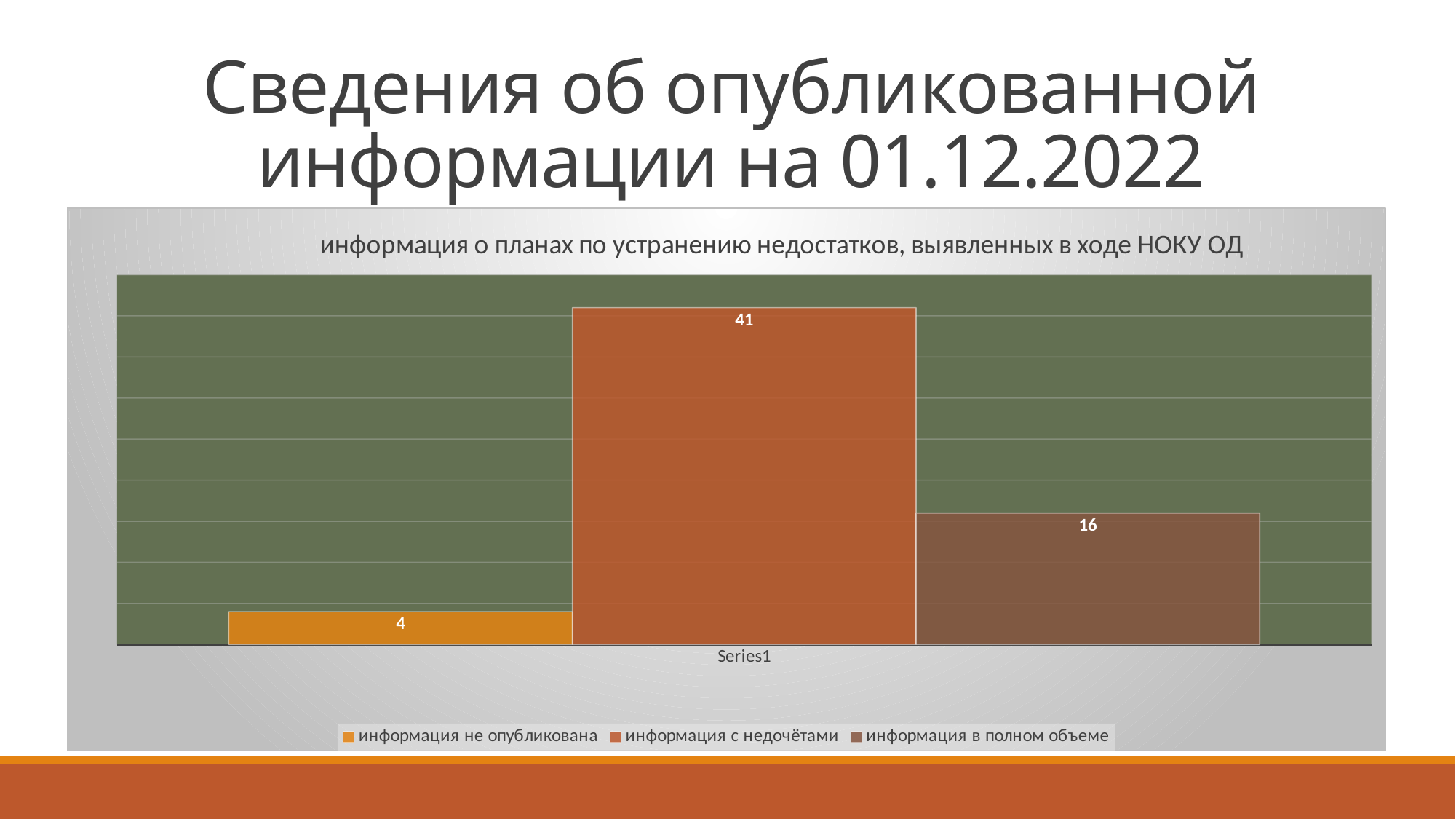
Which is larger: the value for "информация в полном объеме" or the value for "информация не опубликована"? информация в полном объеме What is the value for "информация не опубликована"? 4 What is the value for "информация в полном объеме"? 16 What is the difference between the values for "информация с недочётами" and "информация в полном объеме"? 25 What is the category label shown on the x axis? Series1 How many series does the legend list? 3 What is the title of the chart? информация о планах по устранению недостатков, выявленных в ходе НОКУ ОД Which series has the highest value? информация с недочётами Which series has the lowest value? информация не опубликована What is the value for "информация с недочётами"? 41 What kind of chart is shown on the slide? bar chart What is the difference between the values for "информация в полном объеме" and "информация не опубликована"? 12